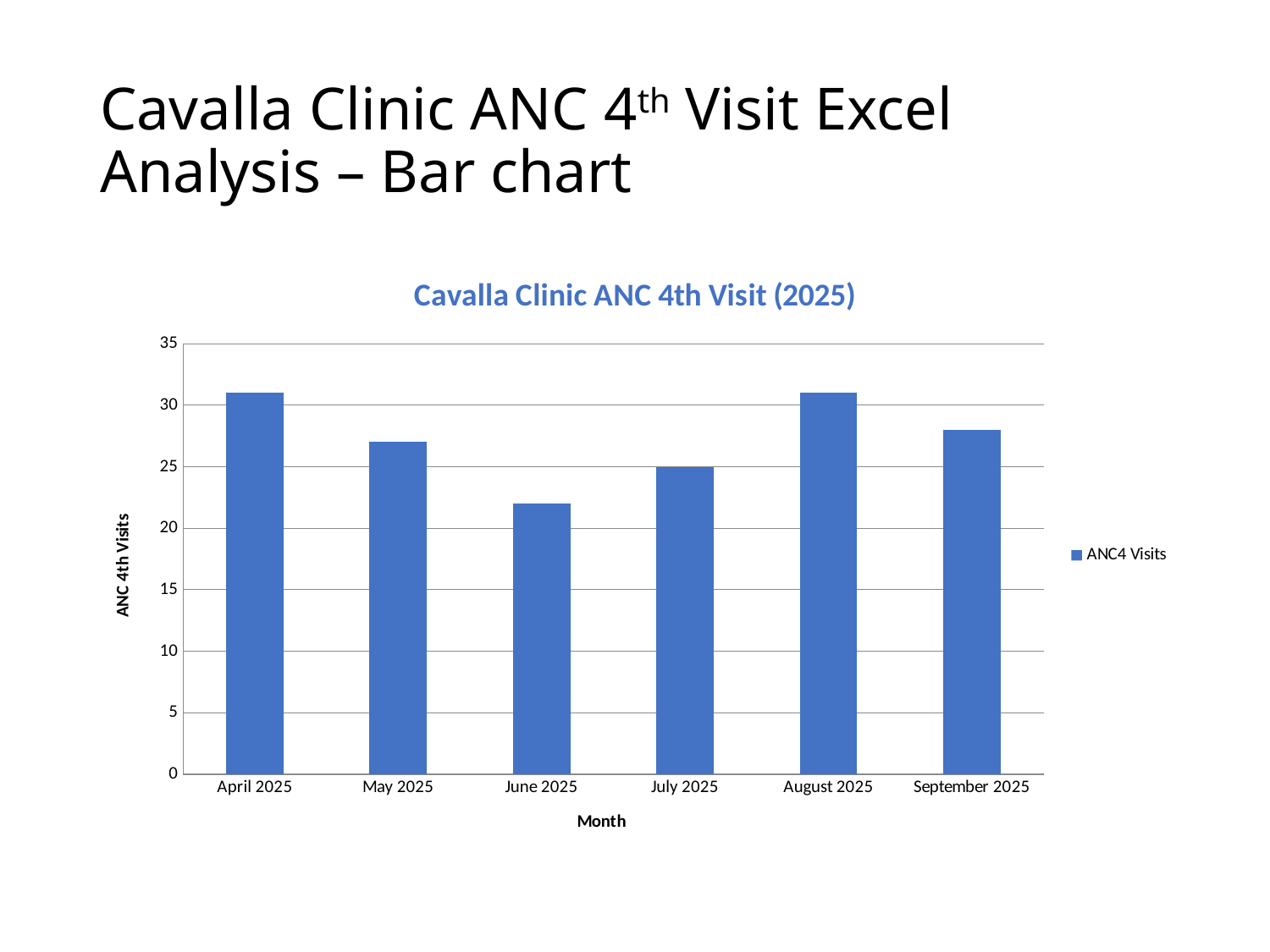
What is the name of the series listed in the legend? ANC4 Visits What kind of chart is shown on the slide? Bar chart Is the value for June 2025 greater or less than 25? less Do the values rise or fall from April 2025 to June 2025? Fall Which month has the lowest number of ANC4 visits? June 2025 What is the title of the chart? Cavalla Clinic ANC 4th Visit (2025) What is the value for July 2025? 25 How many months are shown on the x axis of the chart? 6 Is the value for April 2025 greater or less than 30? greater Is the value for September 2025 greater or less than 30? less How many series does the chart legend list? 1 Which is larger, the value for May 2025 or the value for June 2025? May 2025